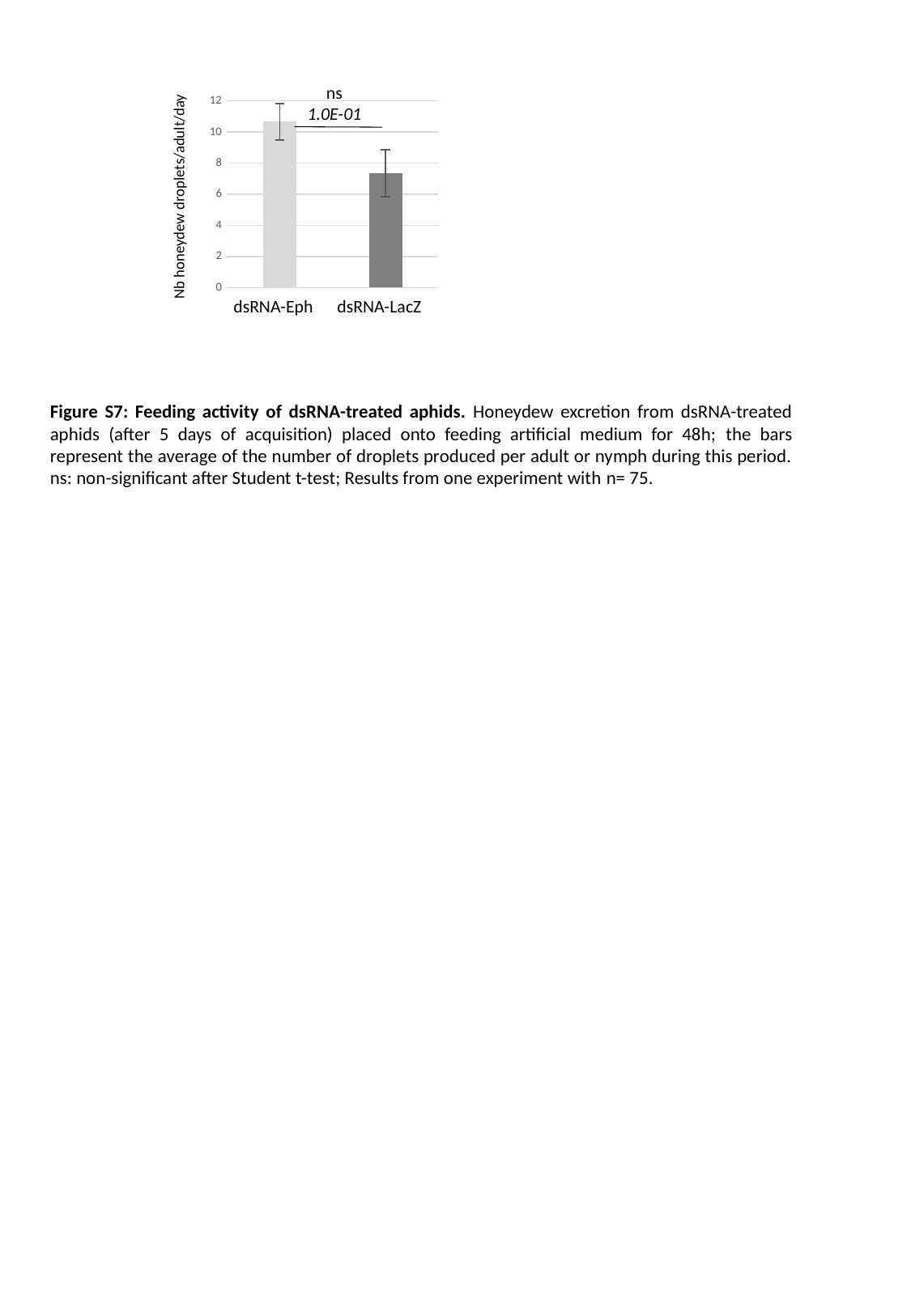
Is the value for dsRNA-Eph greater or less than 10? greater Is the value for dsRNA-LacZ greater or less than 6? greater What kind of chart is shown on the slide? bar chart What is the maximum value shown on the y axis? 12 What is the label of the y axis? Nb honeydew droplets/adult/day Which is larger, the value for dsRNA-Eph or dsRNA-LacZ? dsRNA-Eph Which category has the lowest value? dsRNA-LacZ Is the value for dsRNA-LacZ greater or less than 8? less How many categories are plotted on the x axis? 2 Which category has the highest value? dsRNA-Eph What p-value is printed above the bars? 1.0E-01